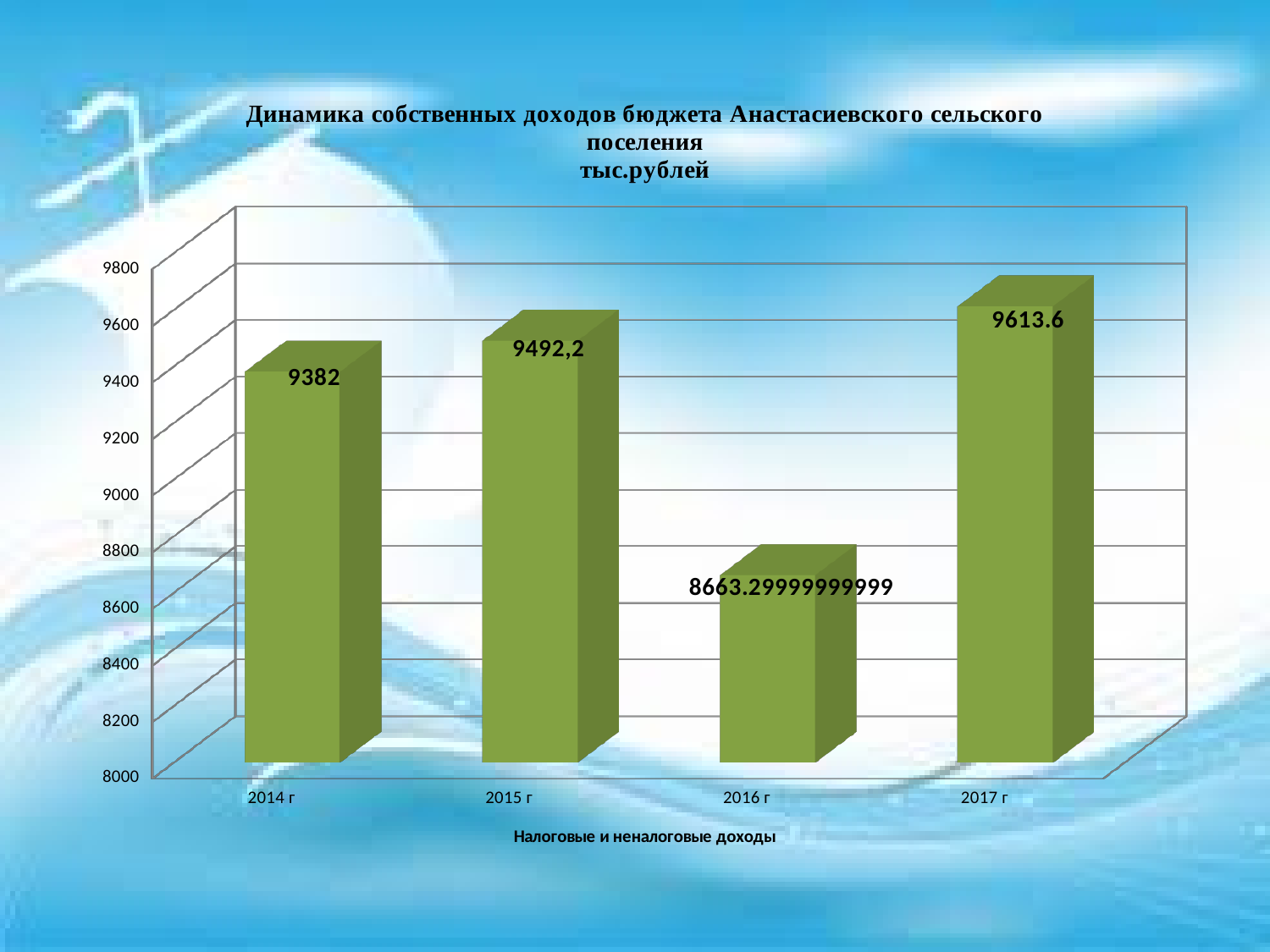
Which is larger, the value for 2015 г or the value for 2014 г? 2015 г What is the value for 2017 г? 9613.6 What kind of chart is shown on the slide? bar chart Which year has the highest value? 2017 г What is the difference between the values for 2017 г and 2014 г? 231.6 Is the value for 2016 г greater or less than 9000? less What is the legend entry shown below the chart? Налоговые и неналоговые доходы What is the value for 2014 г? 9382 What is the value for 2015 г? 9492,2 What is the data label shown on the bar for 2016 г? 8663.29999999999 How many years are shown on the x axis? 4 Which year has the lowest value? 2016 г